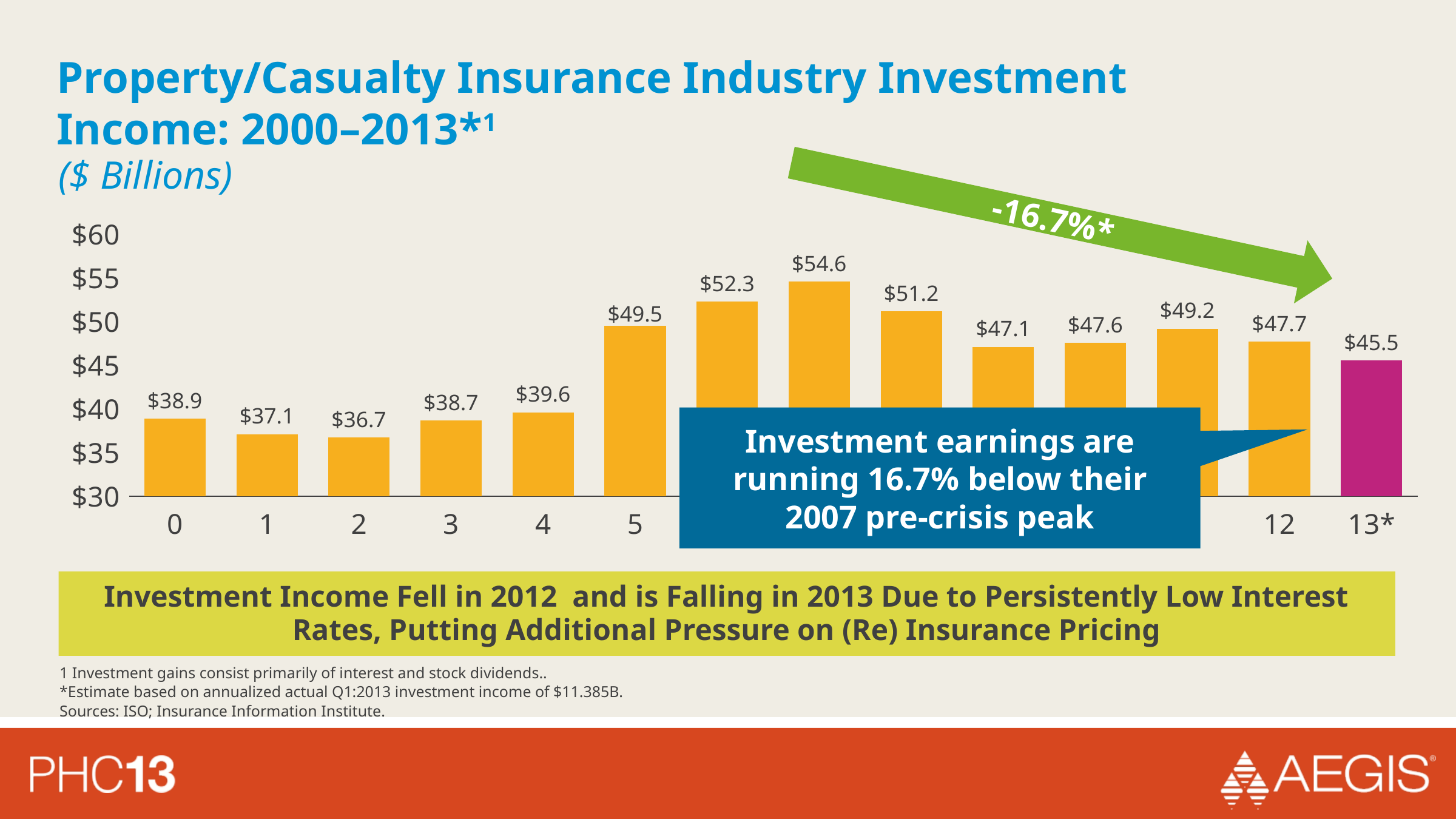
Which is larger, the value for the bar labeled 4 or the bar labeled 5? 5 ($49.5) What is the difference between the values for the bars labeled 12 and 13*? $2.2 Is the value for the bar labeled 1 greater or less than $40? less What is the investment income value for the bar labeled 0 (2000)? $38.9 What percentage decline from the 2007 peak is indicated by the green arrow on the chart? -16.7%* What is the investment income value for the bar labeled 5 (2005)? $49.5 What is the highest value shown on the chart? $54.6 Which bar has the lowest value on the chart? 2 (2002), $36.7 What is the investment income value for the bar labeled 13* (2013 estimate)? $45.5 What is the investment income value for the bar labeled 12 (2012)? $47.7 What type of chart is shown on the slide? bar chart How many bars are plotted on the chart? 14